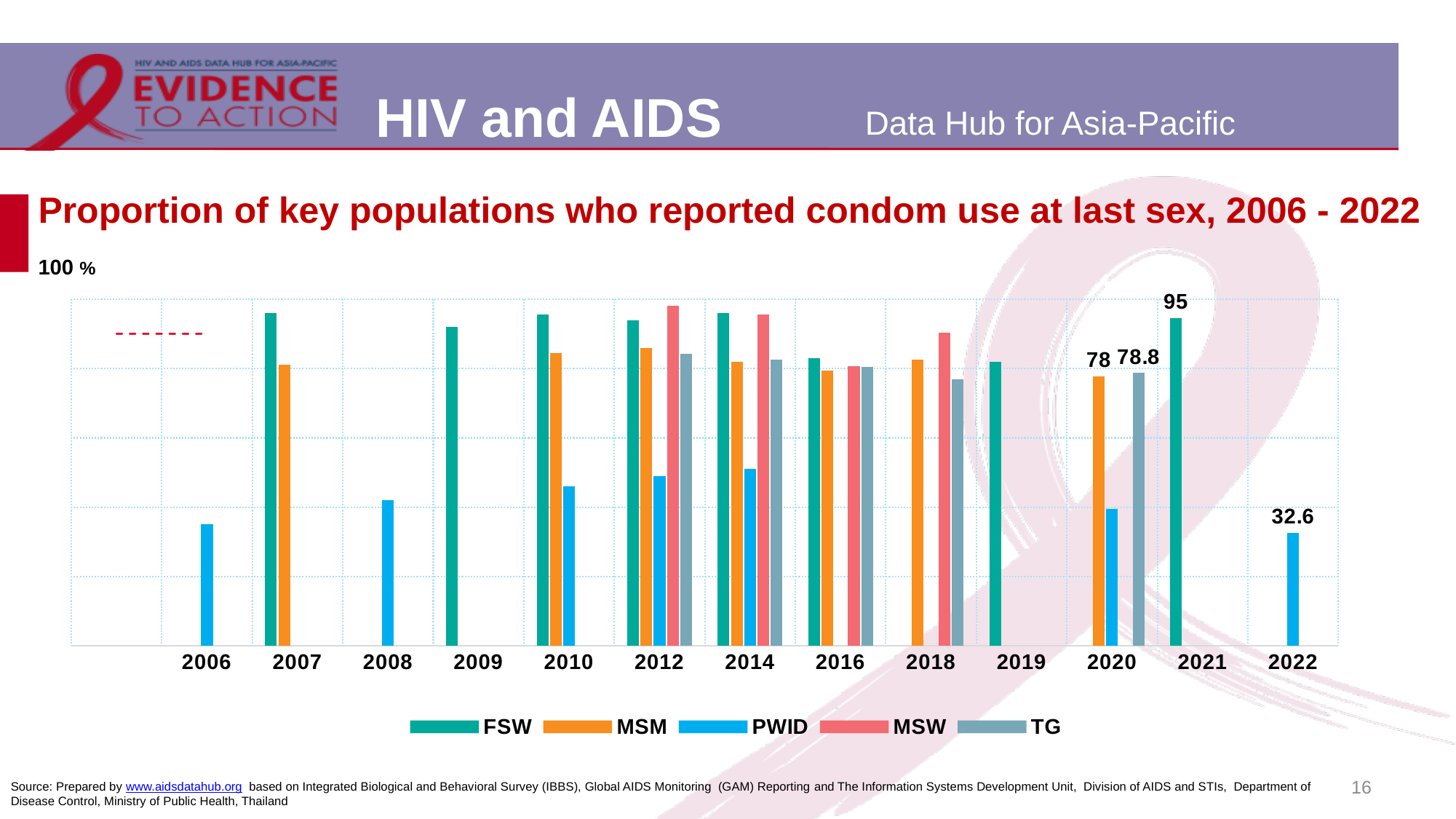
Which key population has the lowest value in 2020? PWID How many series does the legend list? 5 What value is shown for MSM in 2020? 78 What kind of chart is shown on the slide? Bar chart Does the FSW value rise or fall from 2019 to 2021? Rise What value is shown for PWID in 2022? 32.6 What is the difference between the TG value and the MSM value in 2020? 0.8 What value is shown for FSW in 2021? 95 How many years are shown on the x axis? 13 What value is shown for TG in 2020? 78.8 Which is larger: the FSW value in 2021 or the PWID value in 2022? FSW value in 2021 Which key population has the highest value in 2020? TG